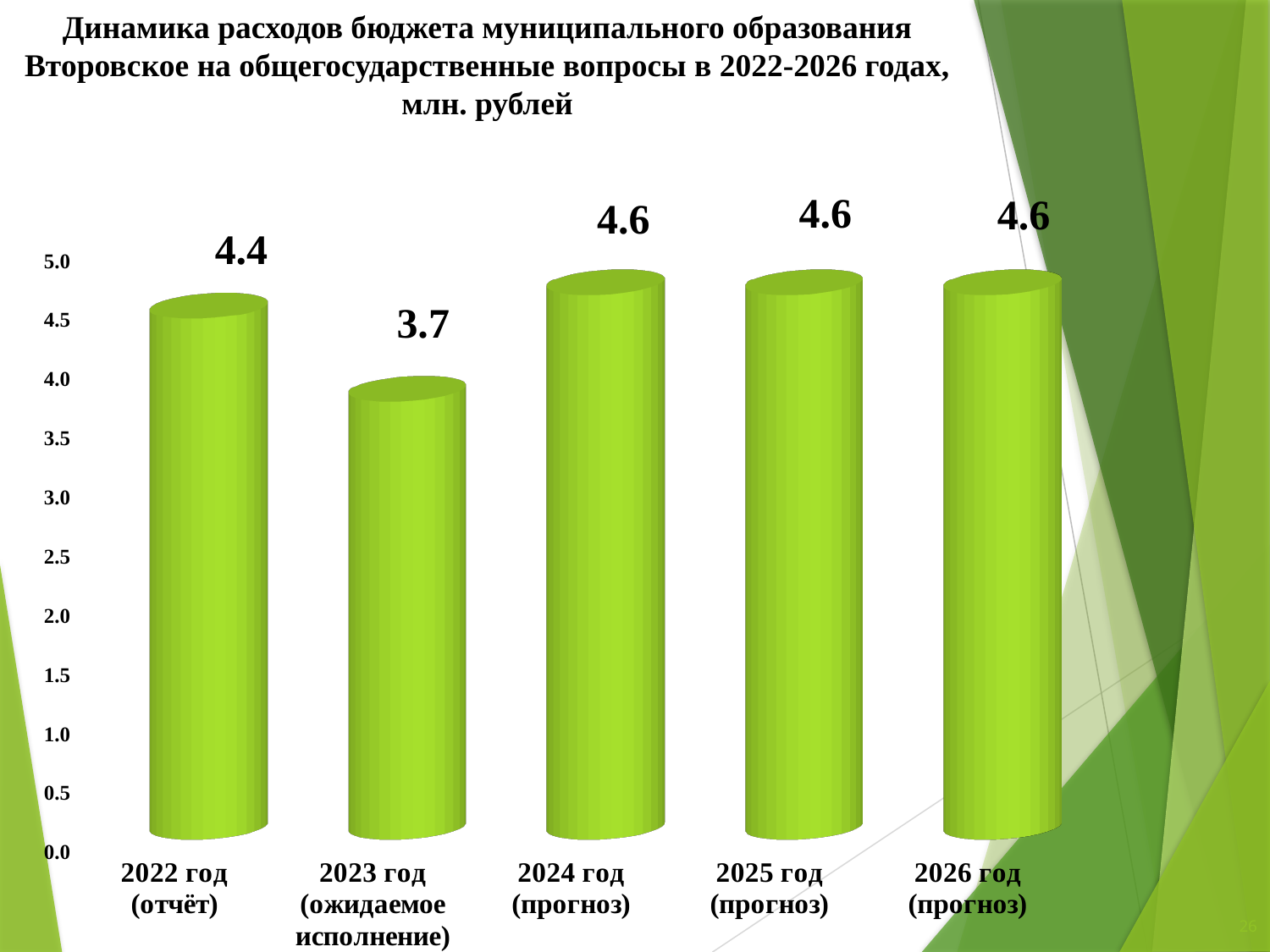
What is the value for 2025 год (прогноз)? 4.6 What is the value for 2022 год (отчёт)? 4.4 Do the values rise or fall from 2023 год to 2024 год? rise Is the value for 2023 год (ожидаемое исполнение) greater or less than 4.0? less Which is larger, the value for 2022 год (отчёт) or the value for 2023 год (ожидаемое исполнение)? 2022 год (отчёт) What is the difference between the values for 2022 год (отчёт) and 2023 год (ожидаемое исполнение)? 0.7 What is the difference between the values for 2024 год (прогноз) and 2023 год (ожидаемое исполнение)? 0.9 In what units are the values on the chart expressed, according to the title? млн. рублей What is the value for 2023 год (ожидаемое исполнение)? 3.7 Which year has the lowest value? 2023 год (ожидаемое исполнение) How many categories (years) are shown on the chart? 5 What kind of chart is shown on the slide? bar chart